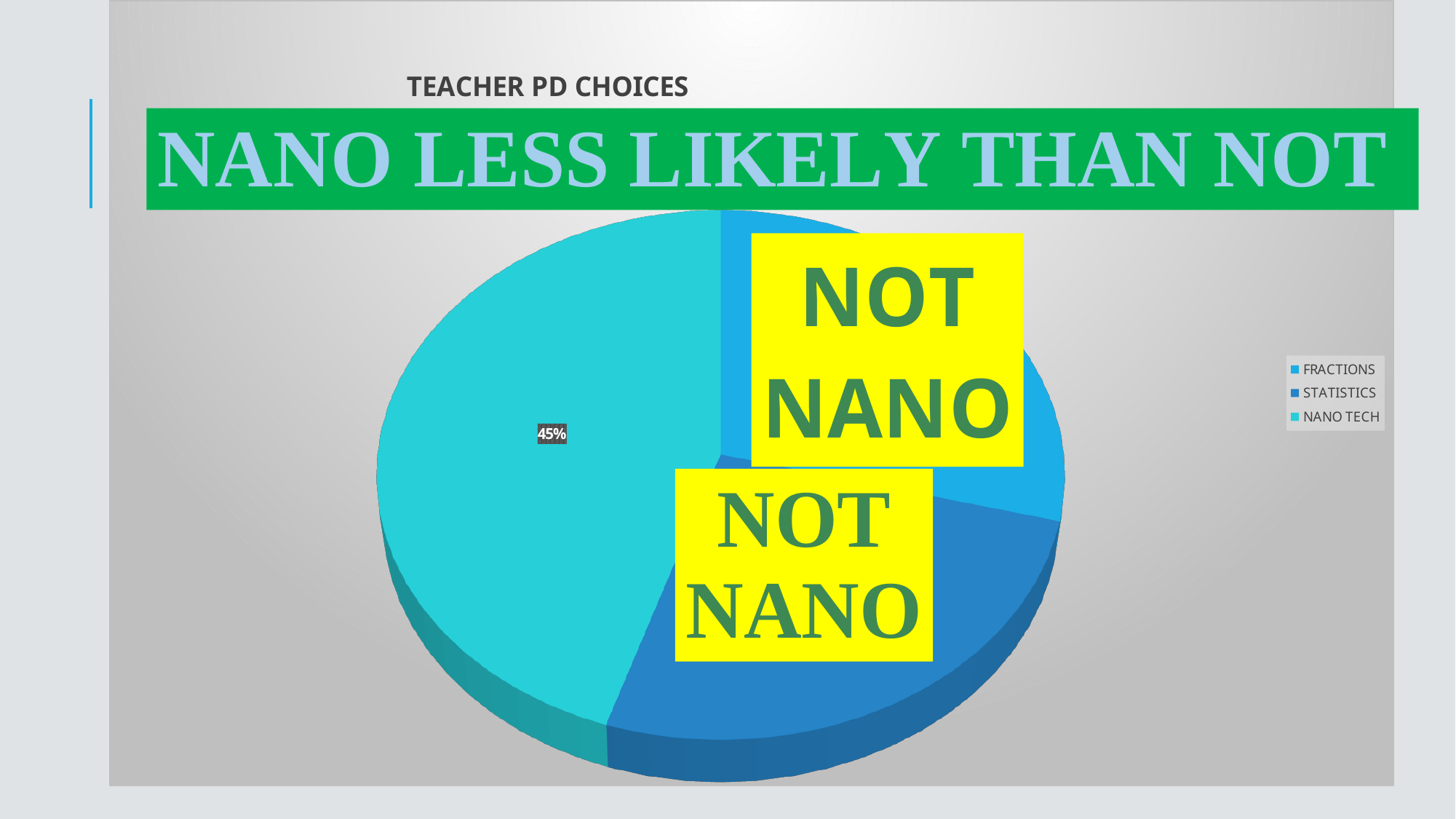
Which slice is larger, NANO TECH or FRACTIONS? NANO TECH Is the NANO TECH slice greater or less than 50% of the pie? less What kind of chart is shown on the slide? pie chart What value is printed on the NANO TECH slice? 45% How many categories does the legend list? 3 What is the title of the chart? TEACHER PD CHOICES What are the three legend entries, in order from top to bottom? FRACTIONS, STATISTICS, NANO TECH Which category has the largest slice of the pie? NANO TECH Which slice is larger, NANO TECH or STATISTICS? NANO TECH What share of the pie does NANO TECH have? 45%